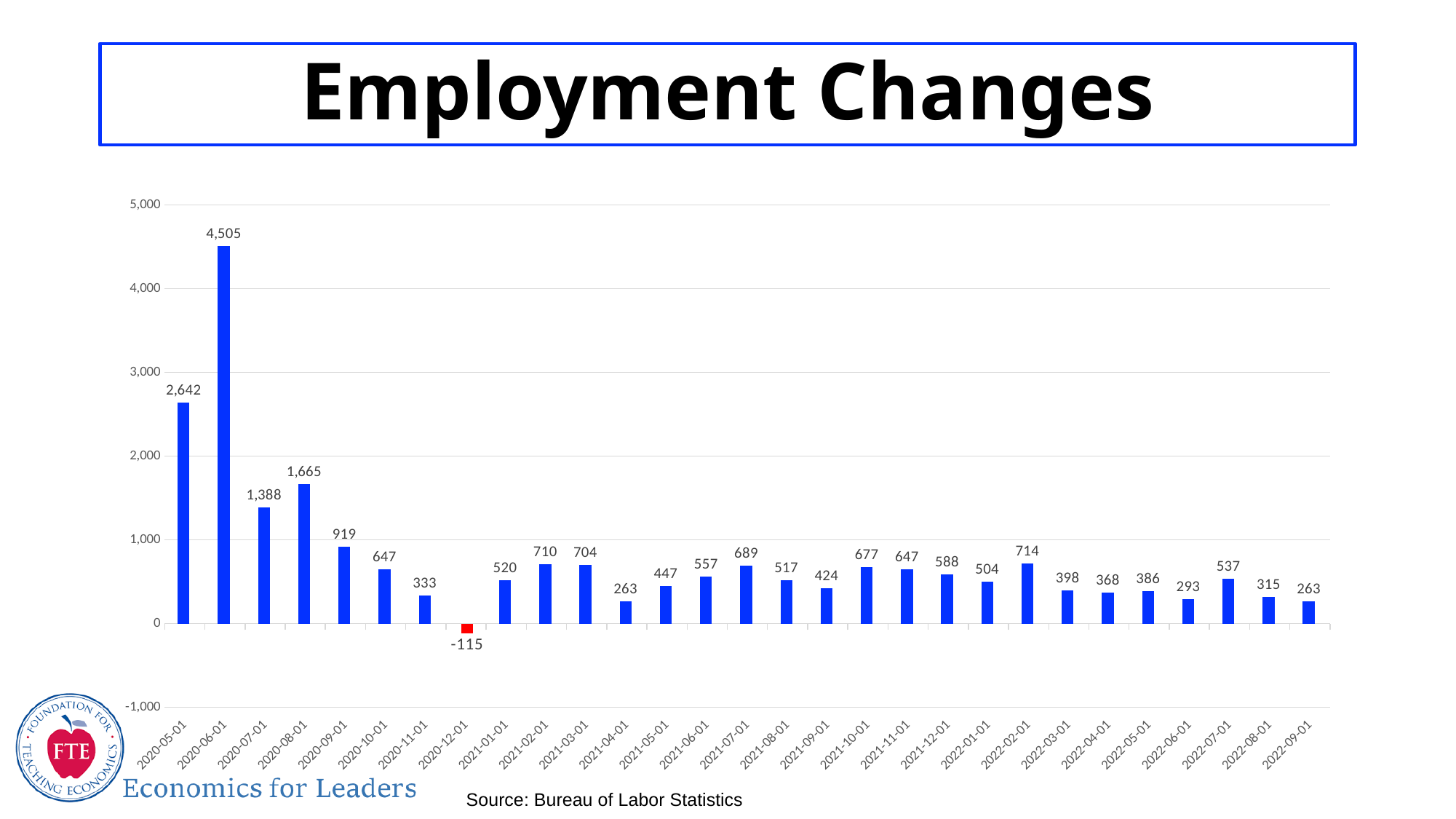
What kind of chart is shown on the slide? bar chart How many months are plotted on the chart? 29 Which month has the highest employment change? 2020-06-01 Do the values rise or fall from 2020-08-01 to 2020-12-01? fall What is the employment change value for 2020-05-01? 2,642 Which is larger, the value for 2022-02-01 or the value for 2022-01-01? 2022-02-01 What is the employment change value for 2020-12-01? -115 Is the value for 2020-09-01 greater or less than 1,000? less Which month has the lowest employment change? 2020-12-01 What is the difference between the values for 2020-06-01 and 2020-05-01? 1,863 What is the employment change value for 2022-09-01? 263 Which month's bar is coloured red instead of blue? 2020-12-01